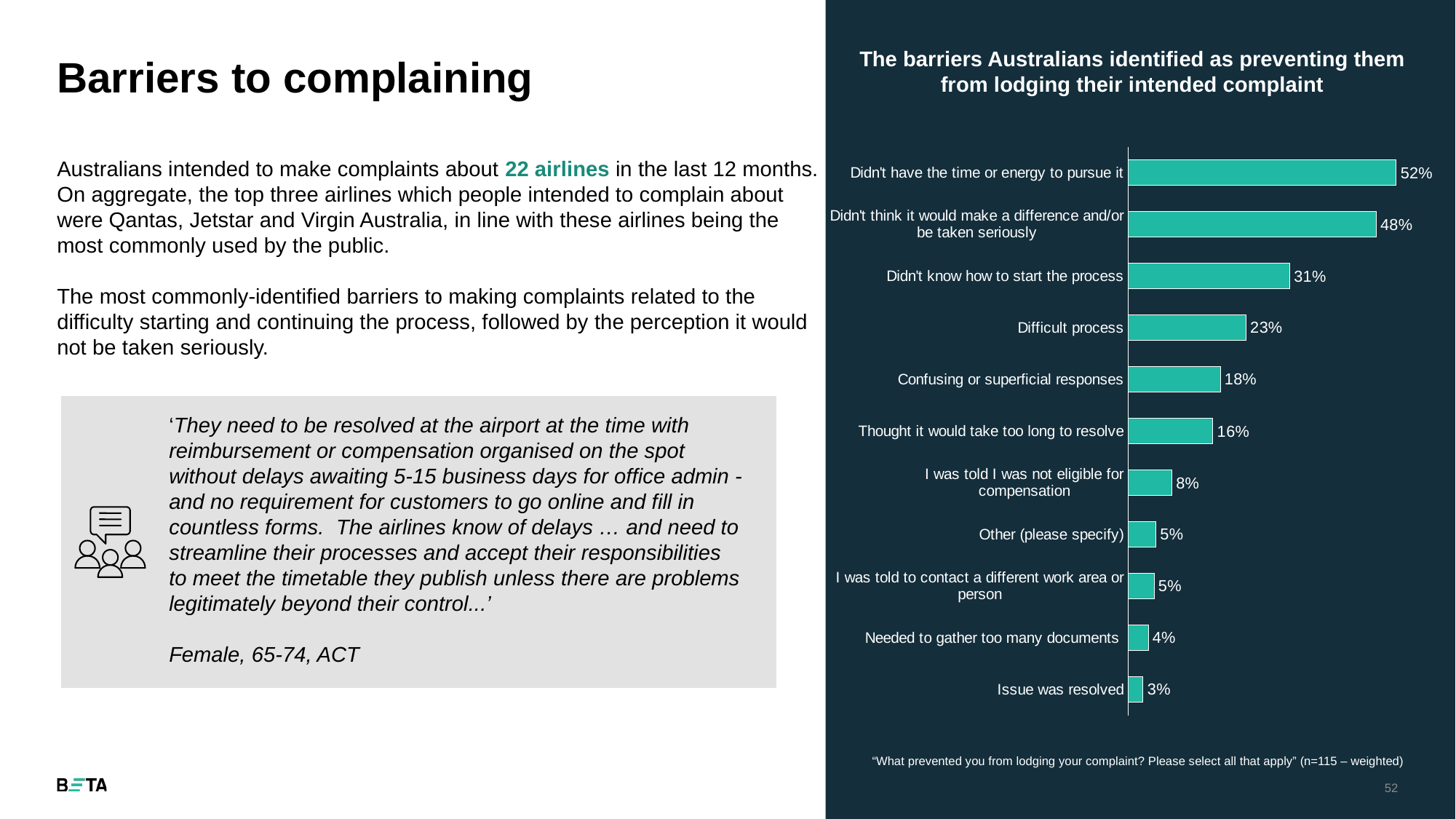
What percentage of respondents said they didn't have the time or energy to pursue the complaint? 52% What is the value for 'Didn't know how to start the process'? 31% Which barrier has the highest percentage? Didn't have the time or energy to pursue it What is the difference between 'Didn't have the time or energy to pursue it' and 'Didn't think it would make a difference and/or be taken seriously'? 4% What is the difference between 'Difficult process' and 'Thought it would take too long to resolve'? 7% Which is larger: 'Difficult process' or 'Confusing or superficial responses'? Difficult process Which barrier has the lowest percentage? Issue was resolved What is the value for 'Needed to gather too many documents'? 4% What is the title of the chart? The barriers Australians identified as preventing them from lodging their intended complaint How many barrier categories are shown in the chart? 11 What type of chart is shown on the slide? Bar chart What percentage cited 'Confusing or superficial responses' as a barrier? 18%